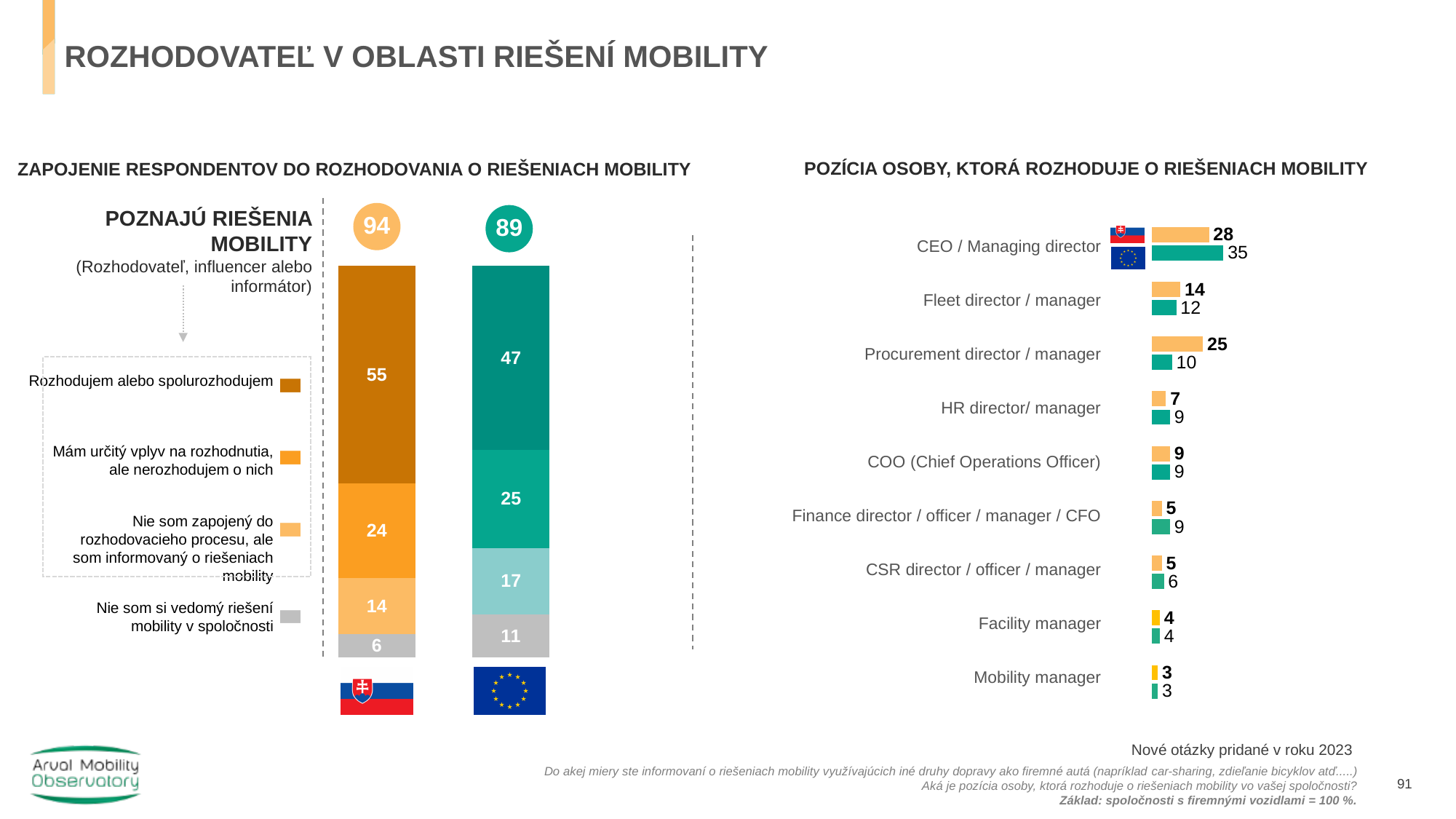
In the right chart, which position has the lowest EU value? Mobility manager In the left chart, what is the total of the Slovakia stacked bar? 99 In the right chart, is the Slovakia value or the EU value larger for Fleet director / manager? Slovakia (14) In the left chart, what number is shown in the circle above the EU bar? 89 What kind of chart is the left chart? Stacked bar chart How many positions are listed in the right chart? 9 In the left chart, what is the difference between the Slovakia and EU values for 'Rozhodujem alebo spolurozhodujem'? 8 In the left chart (ZAPOJENIE RESPONDENTOV DO ROZHODOVANIA O RIEŠENIACH MOBILITY), what is the value for 'Rozhodujem alebo spolurozhodujem' in the Slovakia bar? 55 In the right chart, which position has the highest Slovakia value? CEO / Managing director In the left chart, what is the value for 'Nie som si vedomý riešení mobility v spoločnosti' in the EU bar? 11 In the right chart, what is the Slovakia value for Procurement director / manager? 25 In the right chart (POZÍCIA OSOBY, KTORÁ ROZHODUJE O RIEŠENIACH MOBILITY), what is the EU value for CEO / Managing director? 35